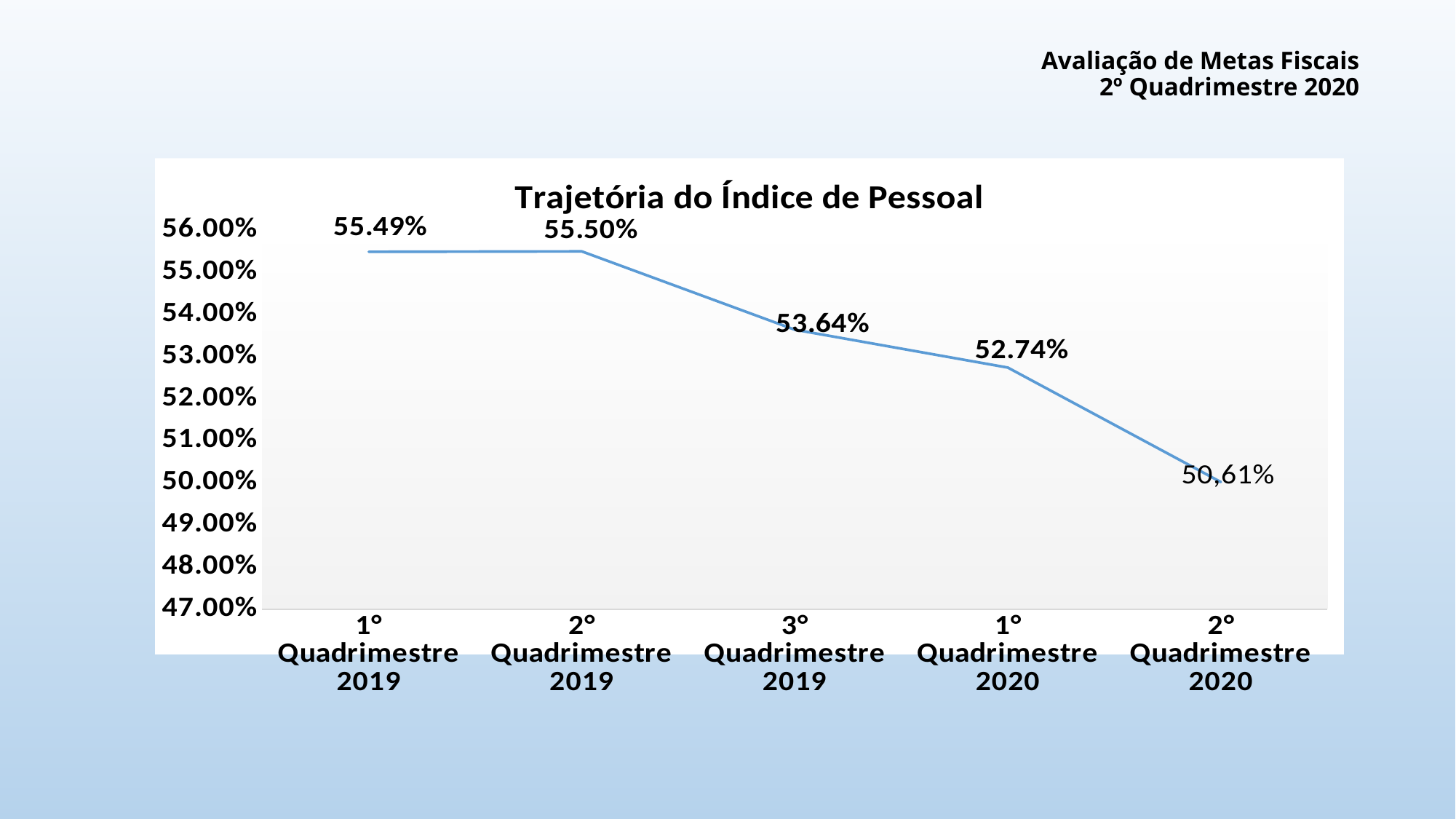
What type of chart is shown on the slide? Line chart How many data points are plotted on the chart? 5 What is the title of the chart? Trajetória do Índice de Pessoal Which is larger, the value for 3° Quadrimestre 2019 or the value for 1° Quadrimestre 2020? 3° Quadrimestre 2019 Does the value rise or fall from 2° Quadrimestre 2019 to 2° Quadrimestre 2020? Fall What is the value for 1° Quadrimestre 2019? 55.49% What is the value for 2° Quadrimestre 2019? 55.50% What is the value for 3° Quadrimestre 2019? 53.64% What is the difference between the value for 1° Quadrimestre 2020 and the value for 2° Quadrimestre 2020? 2.13 percentage points What is the value for 1° Quadrimestre 2020? 52.74% What is the value for 2° Quadrimestre 2020? 50,61% Which period has the lowest value? 2° Quadrimestre 2020